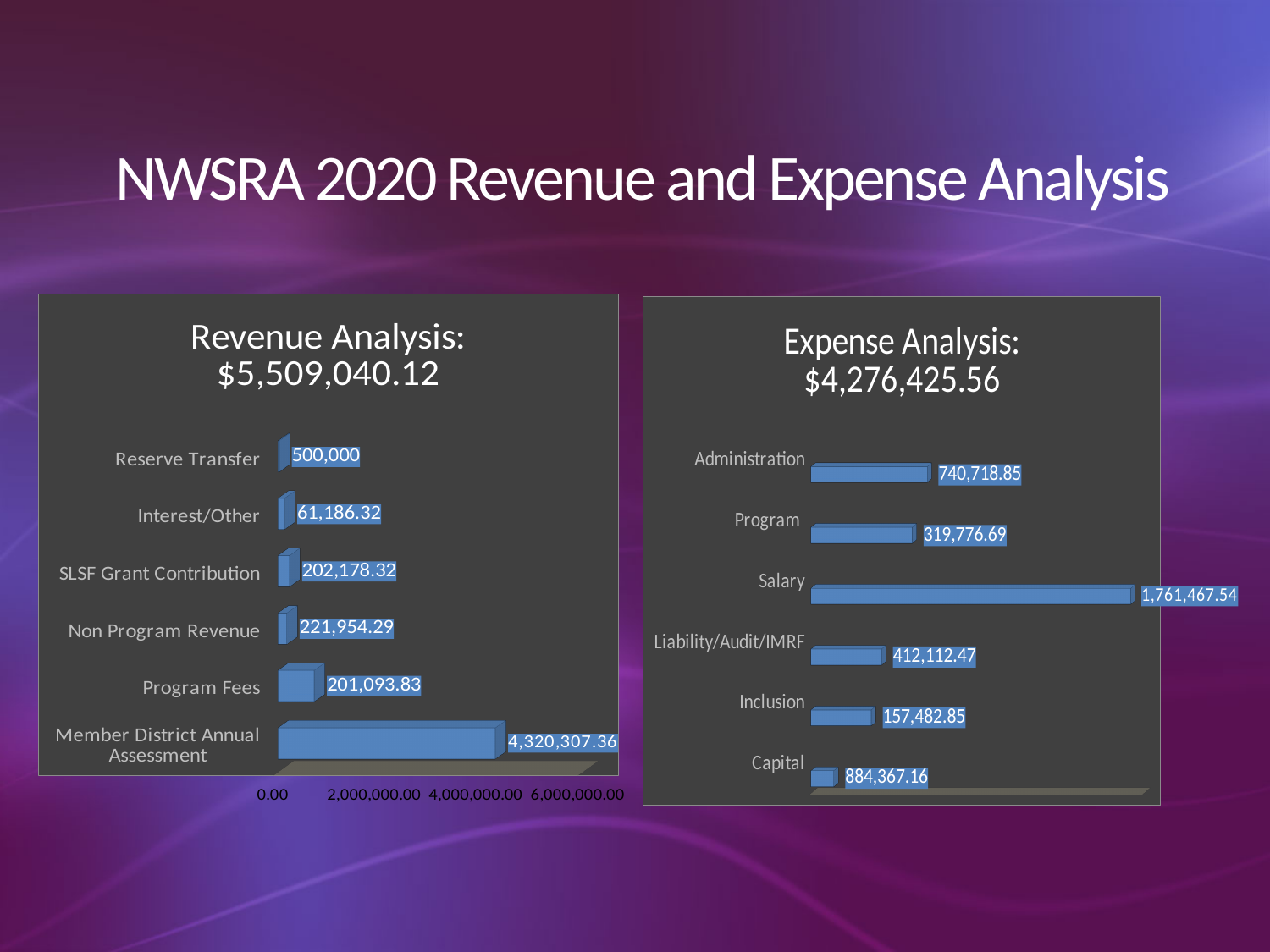
How many categories are shown in the Expense Analysis chart? 6 What type of chart is the Revenue Analysis chart? Bar chart Which category has the highest value in the Revenue Analysis chart? Member District Annual Assessment In the Revenue Analysis chart, what is the difference between Non Program Revenue and Program Fees? 20,860.46 Which category has the highest value in the Expense Analysis chart? Salary In the Expense Analysis chart, what is the value for Salary? 1,761,467.54 In the Revenue Analysis chart, what is the value for Interest/Other? 61,186.32 In the Expense Analysis chart, what is the value for Liability/Audit/IMRF? 412,112.47 What is the value for Member District Annual Assessment in the Revenue Analysis chart? 4,320,307.36 In the Expense Analysis chart, what is the difference between Administration and Program? 420,942.16